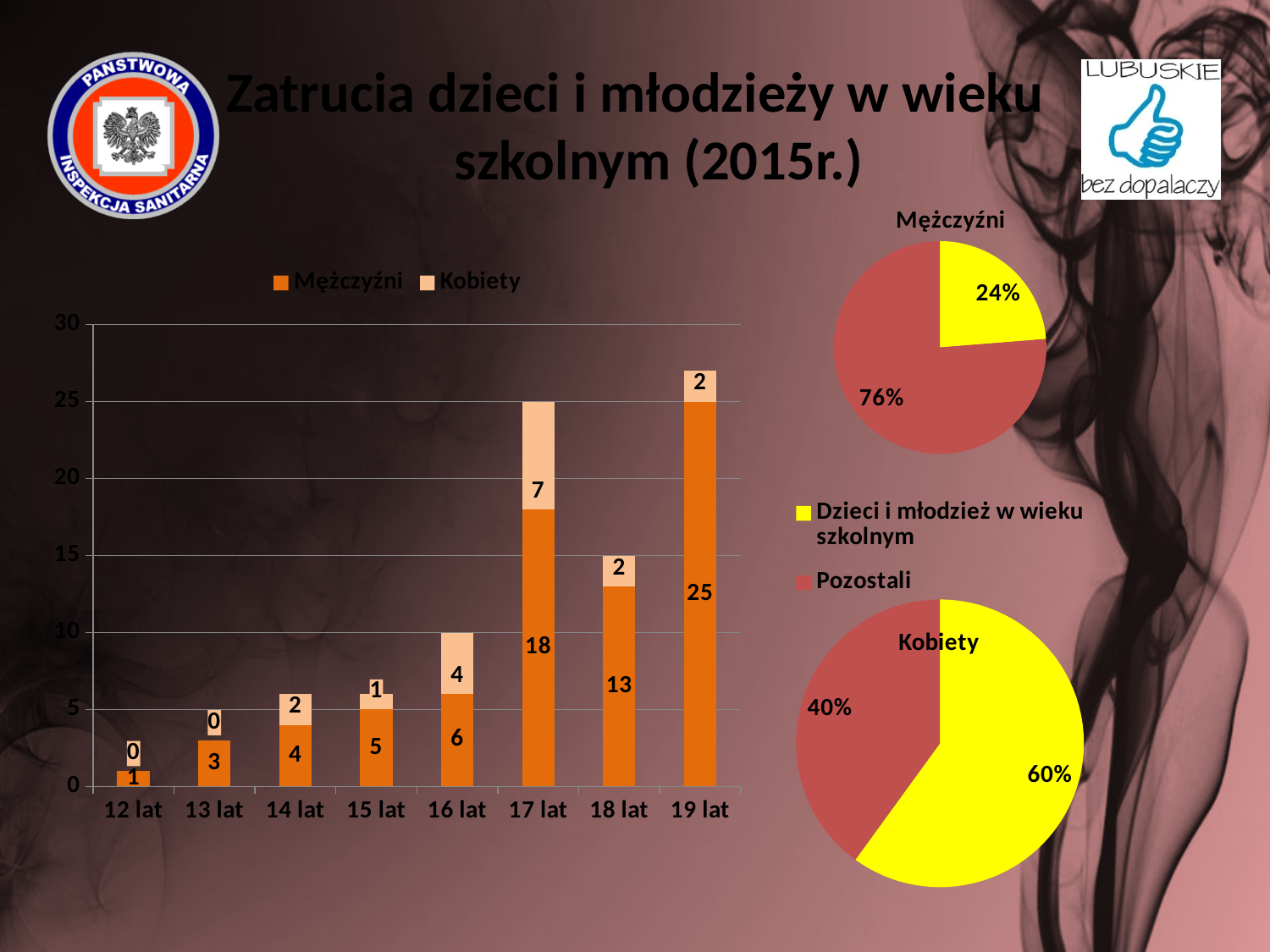
What kind of chart is the chart on the left side of the slide? Stacked bar chart In the stacked bar chart, which age category has the highest Kobiety value? 17 lat In the pie chart titled Mężczyźni, what share is Dzieci i młodzież w wieku szkolnym? 24% In the pie chart titled Kobiety, what share is Pozostali? 40% In the stacked bar chart, which age category has the highest Mężczyźni value? 19 lat How many series does the legend of the stacked bar chart list? 2 How many age categories are shown on the x axis of the stacked bar chart? 8 In the stacked bar chart, what is the Kobiety value for 16 lat? 4 In the stacked bar chart, what is the difference between the Mężczyźni values for 19 lat and 18 lat? 12 In the stacked bar chart, which is larger: the Mężczyźni value for 16 lat or for 15 lat? 16 lat In the stacked bar chart, what is the total of the stacked bar for 17 lat? 25 In the stacked bar chart, what is the Mężczyźni value for 17 lat? 18